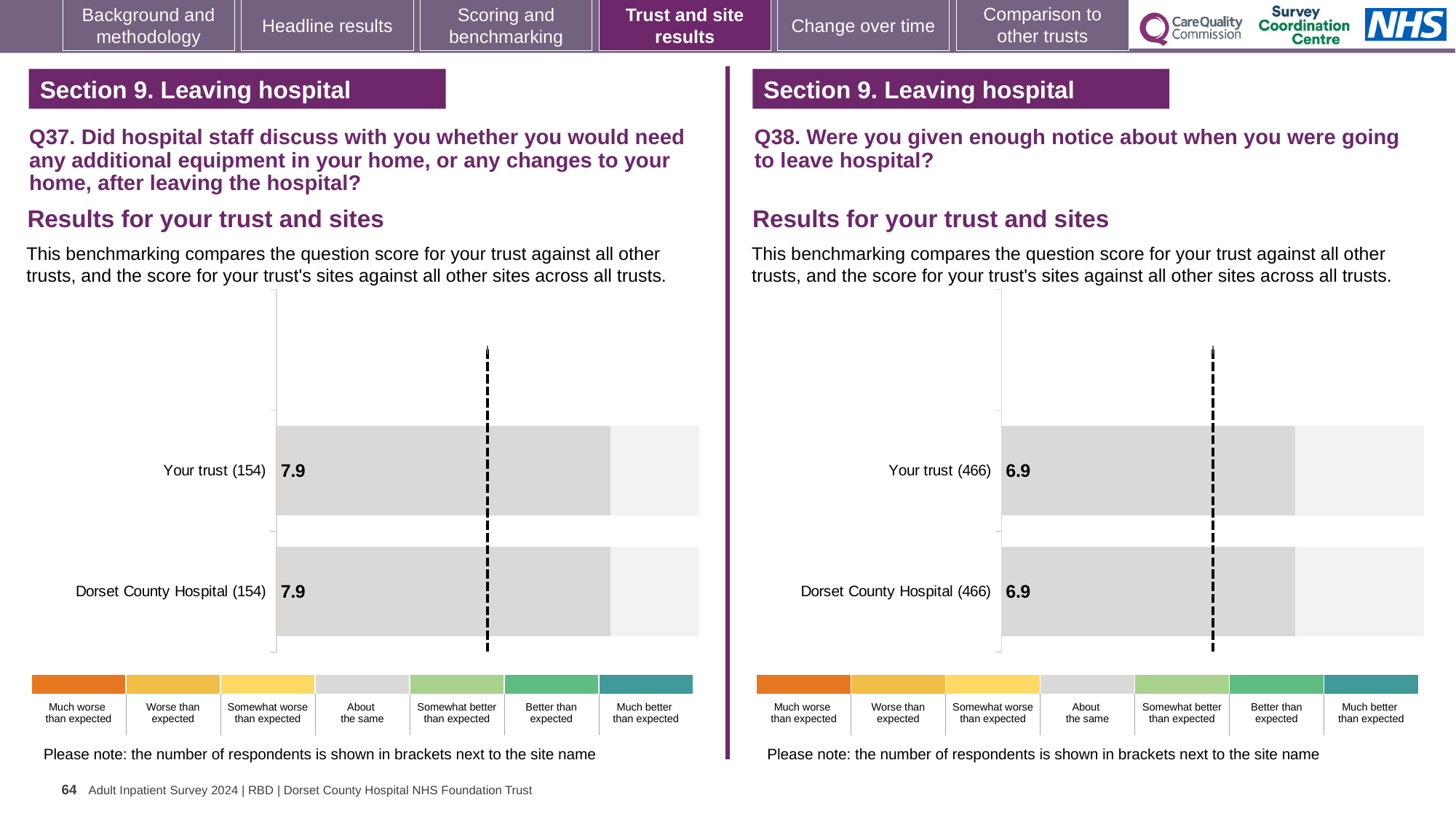
On the Q37 chart (left), what is the score for Your trust? 7.9 On the Q37 chart (left), what is the score for Dorset County Hospital? 7.9 On the Q38 chart (right), what is the score for Dorset County Hospital? 6.9 How many bars are plotted on the Q37 chart (left)? 2 On the Q38 chart (right), what is the difference between the score for Your trust and the score for Dorset County Hospital? 0 Is the score for Your trust on the Q37 chart (left) larger or smaller than the score for Your trust on the Q38 chart (right)? Larger On the Q37 chart (left), how many respondents are shown in brackets next to Your trust? 154 How many bars are plotted on the Q38 chart (right)? 2 On the Q37 chart (left), what is the difference between the score for Your trust and the score for Dorset County Hospital? 0 On the Q38 chart (right), how many respondents are shown in brackets next to Dorset County Hospital? 466 What kind of chart is used on the Q38 chart (right)? Bar chart On the Q38 chart (right), what is the score for Your trust? 6.9